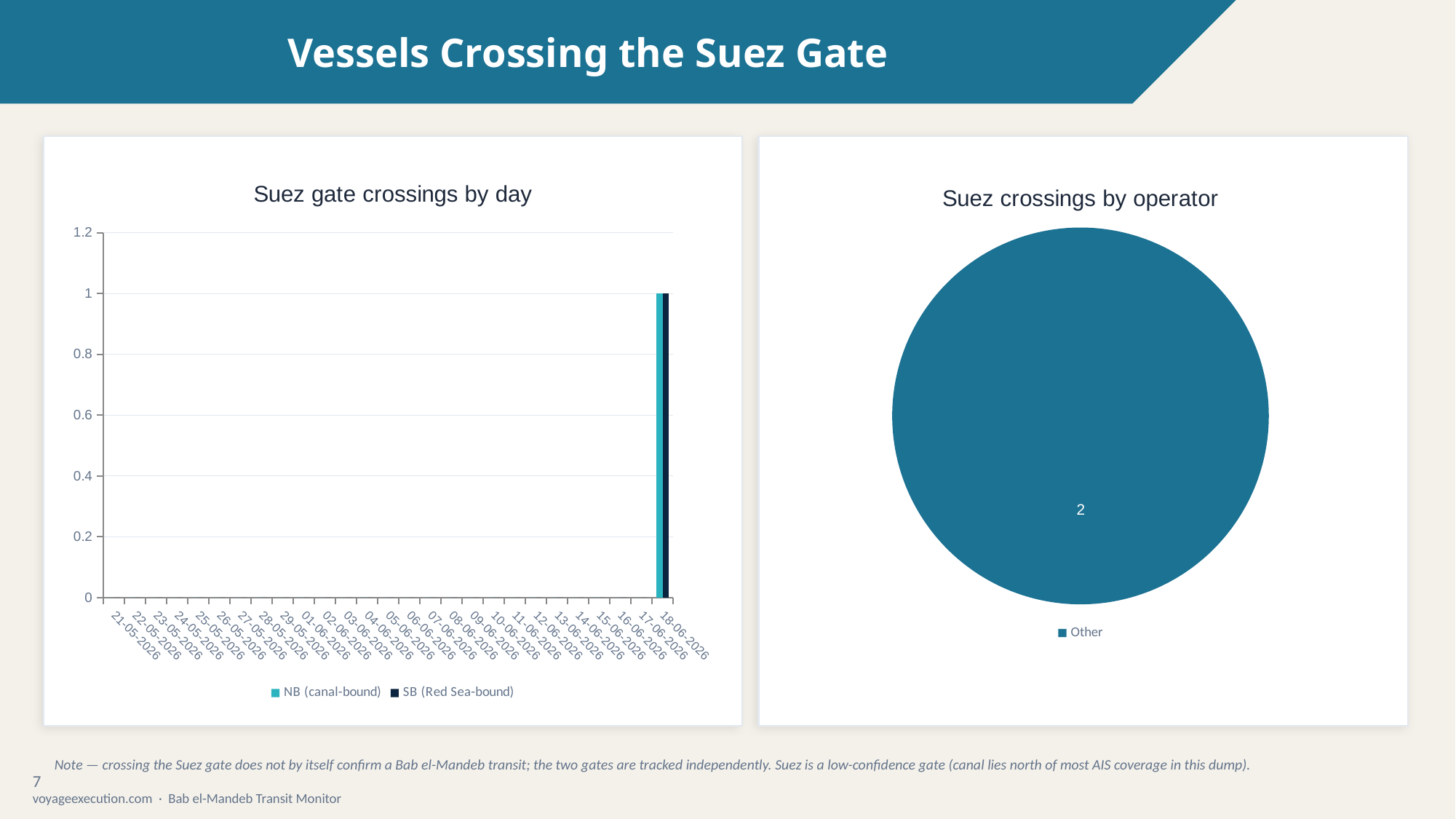
In "Suez gate crossings by day", what is the value for SB (Red Sea-bound) on 18-06-2026? 1 What kind of chart is "Suez crossings by operator"? pie chart What is the title of the chart on the right side of the slide? Suez crossings by operator In "Suez gate crossings by day", is the SB (Red Sea-bound) value on 18-06-2026 greater or less than 0.8? greater In "Suez gate crossings by day", how many series does the legend list? 2 What kind of chart is "Suez gate crossings by day"? bar chart In "Suez crossings by operator", what is the value shown for Other? 2 In "Suez gate crossings by day", which date has the highest NB (canal-bound) value? 18-06-2026 In "Suez gate crossings by day", what are the two legend entries? NB (canal-bound) and SB (Red Sea-bound) In "Suez crossings by operator", how many slices does the pie have? 1 In "Suez gate crossings by day", what is the value for NB (canal-bound) on 18-06-2026? 1 In "Suez crossings by operator", what share of the pie does Other represent? 100%